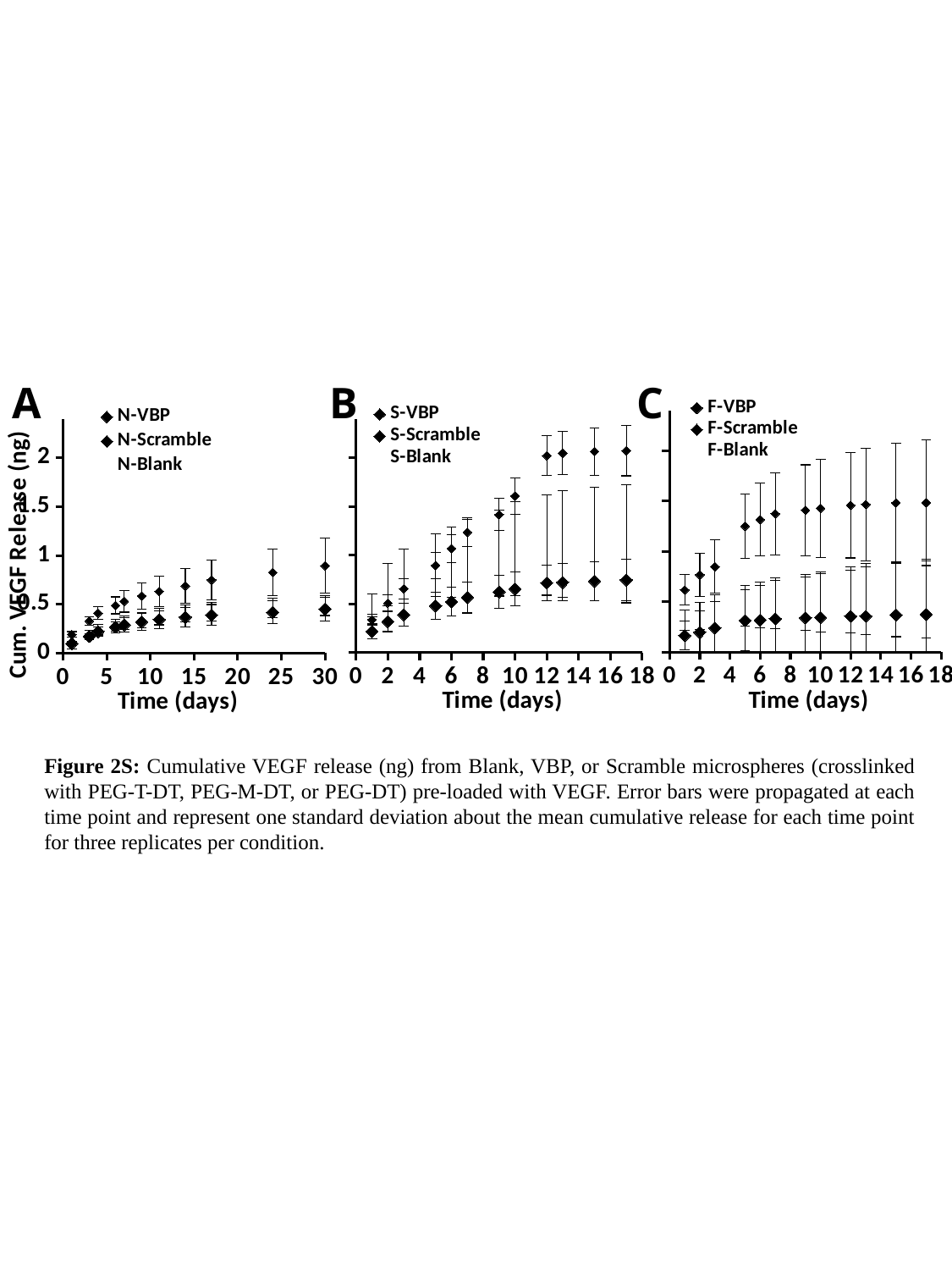
In chart C, is the highest plotted point at day 1 greater or less than 1? less How many series does the legend of chart A list? 3 In chart C, is the lowest plotted point at day 17 greater or less than 0.5? less In chart B, is the highest plotted point at day 10 greater or less than 1.5? greater How many series does the legend of chart C list? 3 What are the legend entries of chart B? S-VBP, S-Scramble, S-Blank What is the y-axis label shared by the charts? Cum. VEGF Release (ng) In chart B, do the plotted values generally rise or fall as time increases? rise What kind of chart is chart A? scatter chart